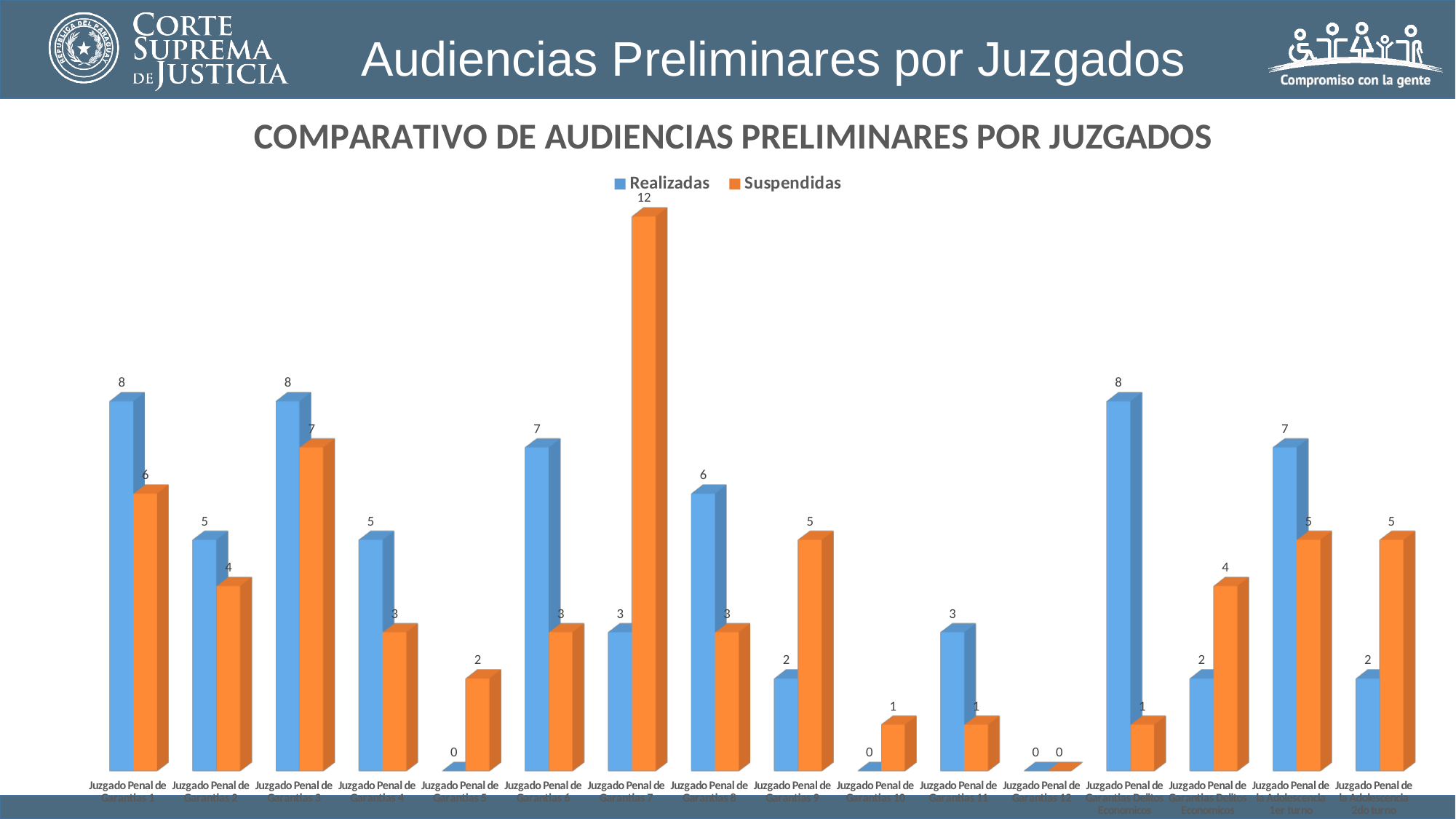
How many series does the legend list? 2 What is the Realizadas value for Juzgado Penal de Garantías 12? 0 For Juzgado Penal de Garantías 9, which is larger, Realizadas or Suspendidas? Suspendidas What is the Suspendidas value for Juzgado Penal de Garantías 7? 12 What is the title of the chart? COMPARATIVO DE AUDIENCIAS PRELIMINARES POR JUZGADOS What is the Realizadas value for Juzgado Penal de Garantías 6? 7 What is the difference between Realizadas and Suspendidas for Juzgado Penal de Garantías 1? 2 What type of chart is shown on the slide? Bar chart What is the Suspendidas value for Juzgado Penal de Garantías 3? 7 What are the two series named in the legend? Realizadas and Suspendidas Which category has the highest Suspendidas value? Juzgado Penal de Garantías 7 How many categories (juzgados) are shown on the x axis? 16